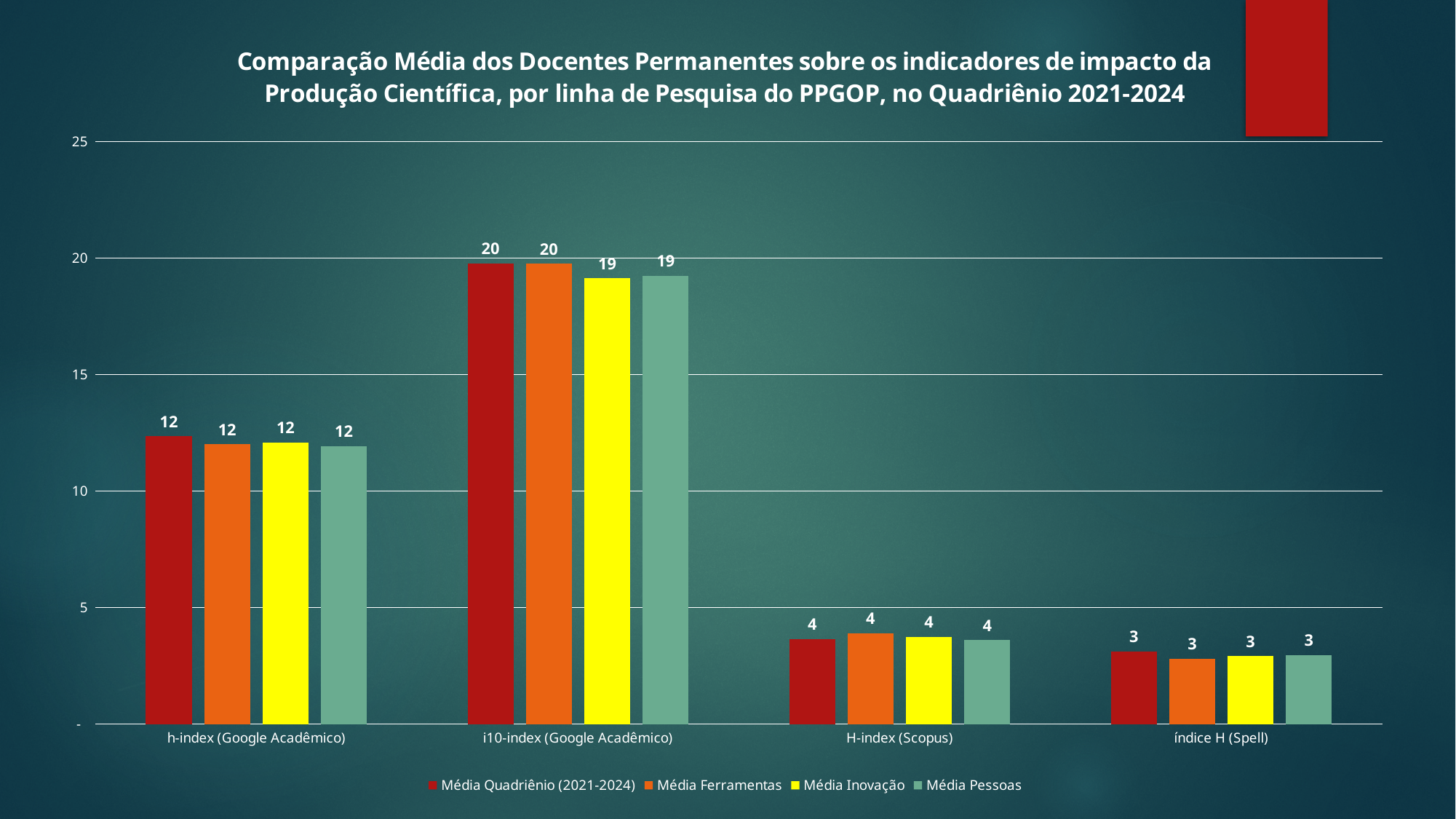
Which category has the lowest value for Média Pessoas? índice H (Spell) What is the value of Média Quadriênio (2021-2024) for i10-index (Google Acadêmico)? 20 What is the value of Média Inovação for i10-index (Google Acadêmico)? 19 What kind of chart is shown on the slide? bar chart What is the difference between the Média Quadriênio (2021-2024) values for i10-index (Google Acadêmico) and h-index (Google Acadêmico)? 8 How many series does the legend list? 4 How many categories are shown on the x axis? 4 Which is larger for Média Inovação: h-index (Google Acadêmico) or H-index (Scopus)? h-index (Google Acadêmico) Which category has the highest value for Média Quadriênio (2021-2024)? i10-index (Google Acadêmico) Is the value of Média Ferramentas for i10-index (Google Acadêmico) greater or less than 15? greater What is the value of Média Ferramentas for índice H (Spell)? 3 What is the value of Média Pessoas for h-index (Google Acadêmico)? 12